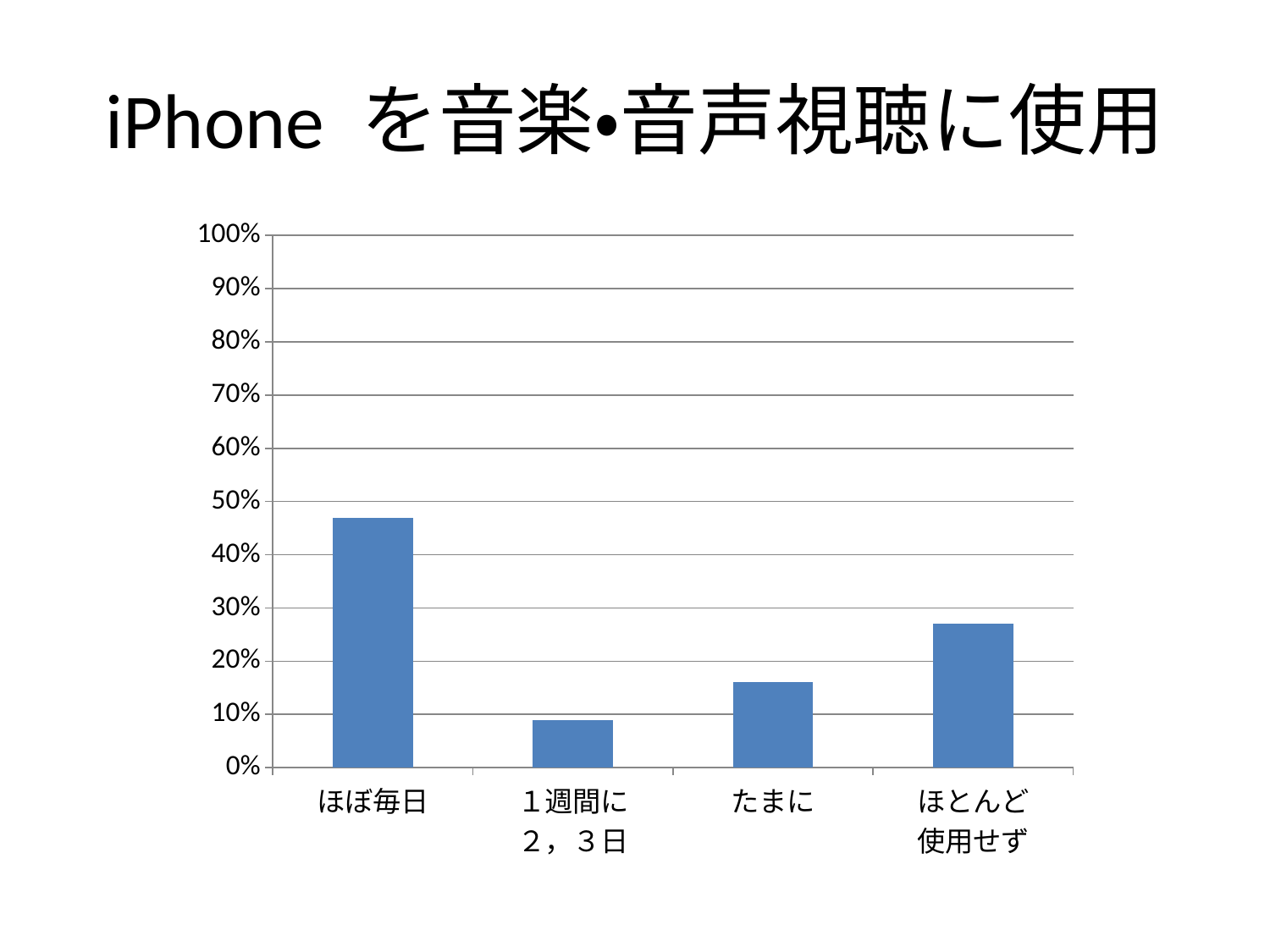
Is the value for ほぼ毎日 greater or less than 50%? less Is the value for ほぼ毎日 greater or less than 40%? greater Which category has the lowest value in the chart? １週間に２，３日 What kind of chart is shown on the slide? bar chart Which category has the highest value in the chart? ほぼ毎日 Is the value for たまに greater or less than 20%? less What is the title of the slide containing the chart? iPhone を音楽•音声視聴に使用 Which is larger, the value for ほぼ毎日 or the value for ほとんど使用せず? ほぼ毎日 How many categories are shown on the x axis of the chart? 4 Which is larger, the value for たまに or the value for ほとんど使用せず? ほとんど使用せず